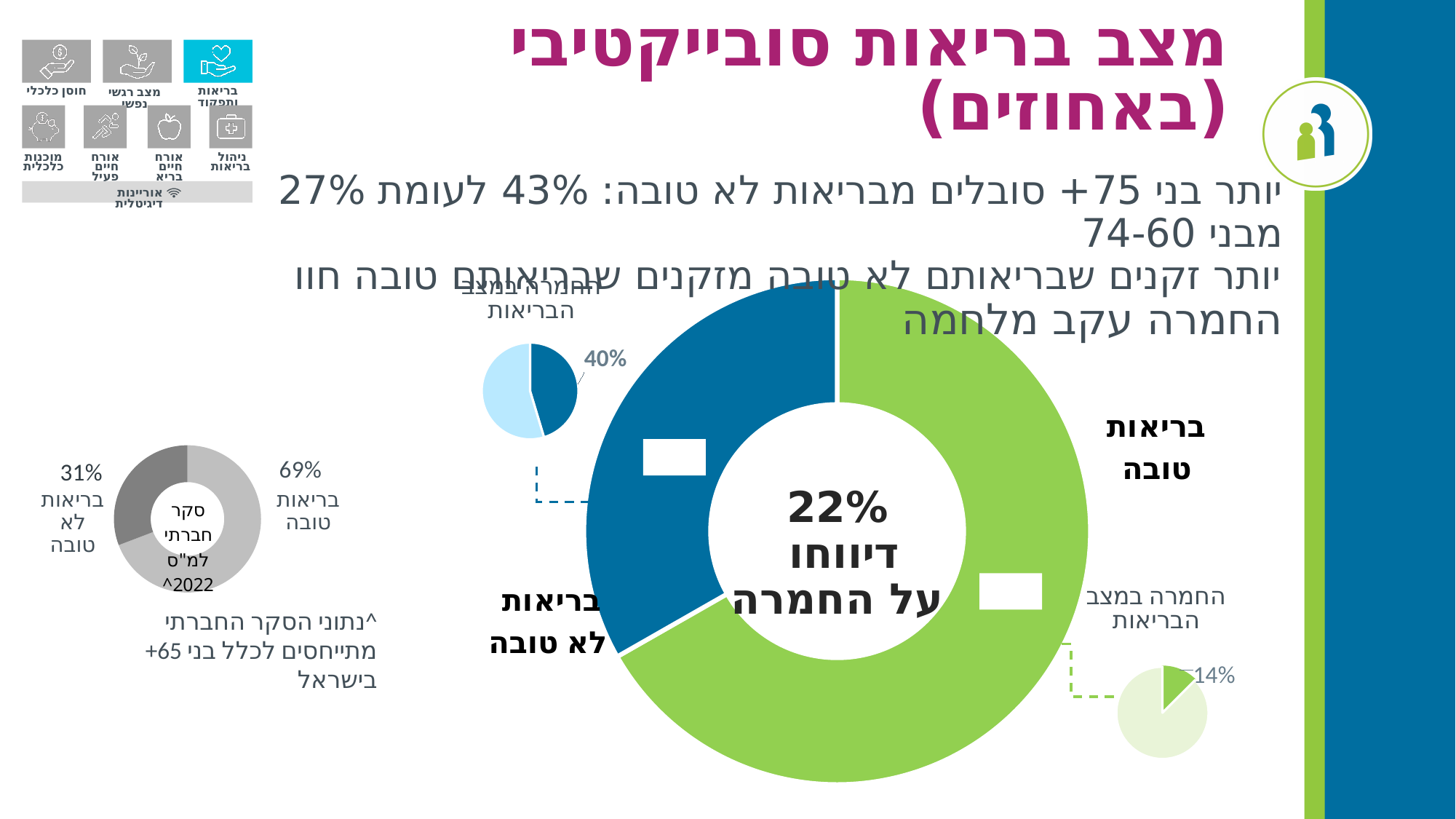
In the small donut chart on the left (סקר חברתי למ"ס 2022), what percentage is shown for בריאות לא טובה? 31% In the small pie chart attached to the בריאות טובה segment of the large donut, what percentage is labelled for החמרה במצב הבריאות? 14% In the small donut chart on the left (סקר חברתי למ"ס 2022), how many segments are there? 2 In the large donut chart, how many segments are there? 2 Which small pie chart shows a higher share of החמרה במצב הבריאות: the one attached to בריאות לא טובה or the one attached to בריאות טובה? the one attached to בריאות לא טובה In the small donut chart on the left (סקר חברתי למ"ס 2022), what is the difference between the share for בריאות טובה and the share for בריאות לא טובה? 38% In the small pie chart attached to the בריאות לא טובה segment of the large donut, what percentage is labelled for החמרה במצב הבריאות? 40% In the large donut chart, which segment is larger: בריאות טובה or בריאות לא טובה? בריאות טובה In the small donut chart on the left (סקר חברתי למ"ס 2022), what percentage is shown for בריאות טובה? 69% What type of chart is the large chart in the centre of the slide? donut chart In the small donut chart on the left (סקר חברתי למ"ס 2022), which category has the larger share? בריאות טובה What percentage is printed in the centre of the large donut chart? 22%